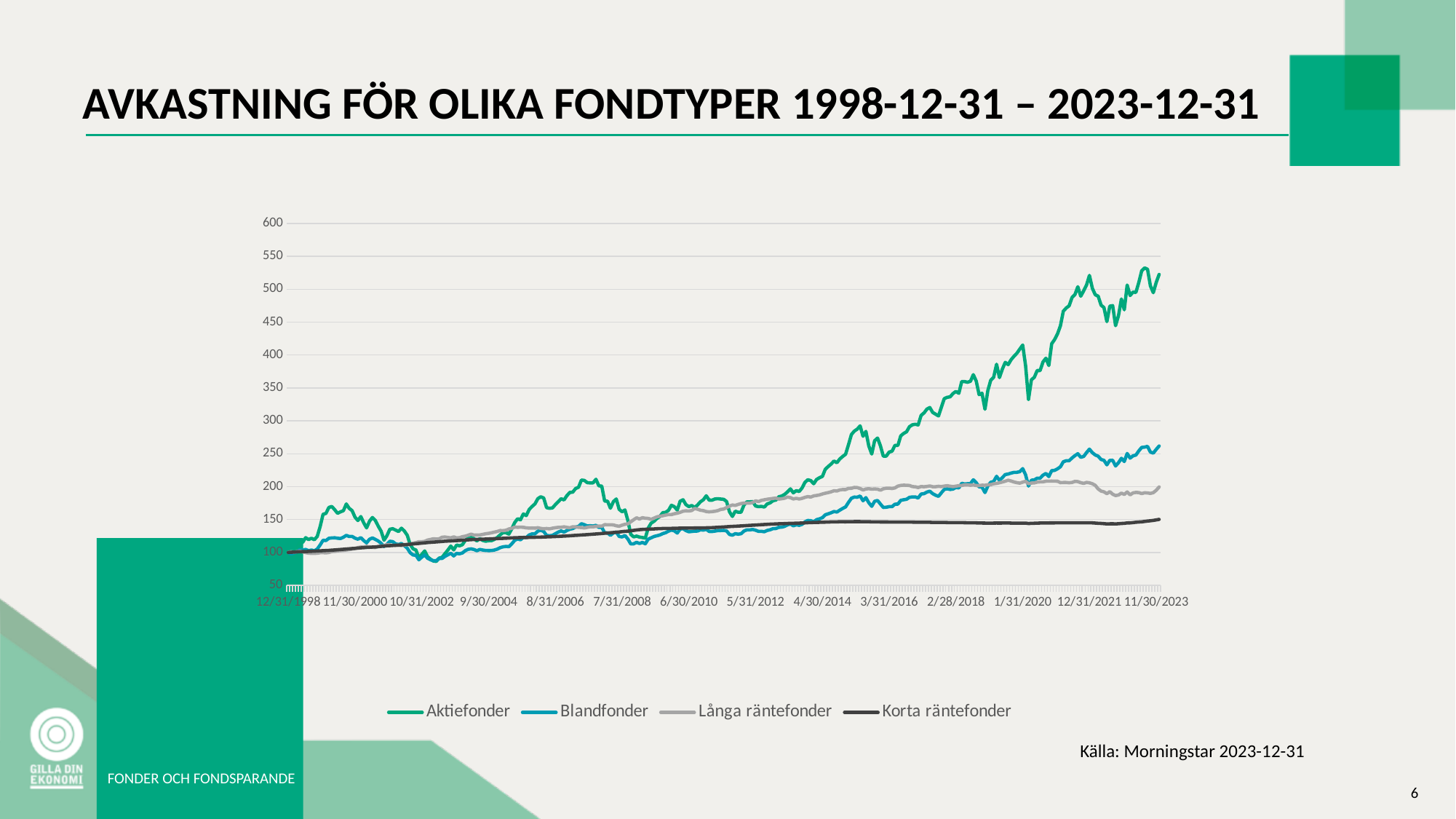
Which series has the highest value at the end of the period (11/30/2023)? Aktiefonder Is the value for Aktiefonder at the end of the period greater or less than 500? greater Is the value for Korta räntefonder at the end of the period greater or less than 200? less Is the value for Blandfonder at the end of the period greater or less than 200? greater What kind of chart is shown on the slide? line chart Does the Korta räntefonder line generally rise or fall over the period shown? rise Which series is drawn in green in the chart? Aktiefonder What is the highest value shown on the vertical axis? 600 At the end of the period, which is larger: Blandfonder or Långa räntefonder? Blandfonder How many series does the legend list? 4 What is the title of the chart on the slide? AVKASTNING FÖR OLIKA FONDTYPER 1998-12-31 – 2023-12-31 Which series has the lowest value at the end of the period (11/30/2023)? Korta räntefonder